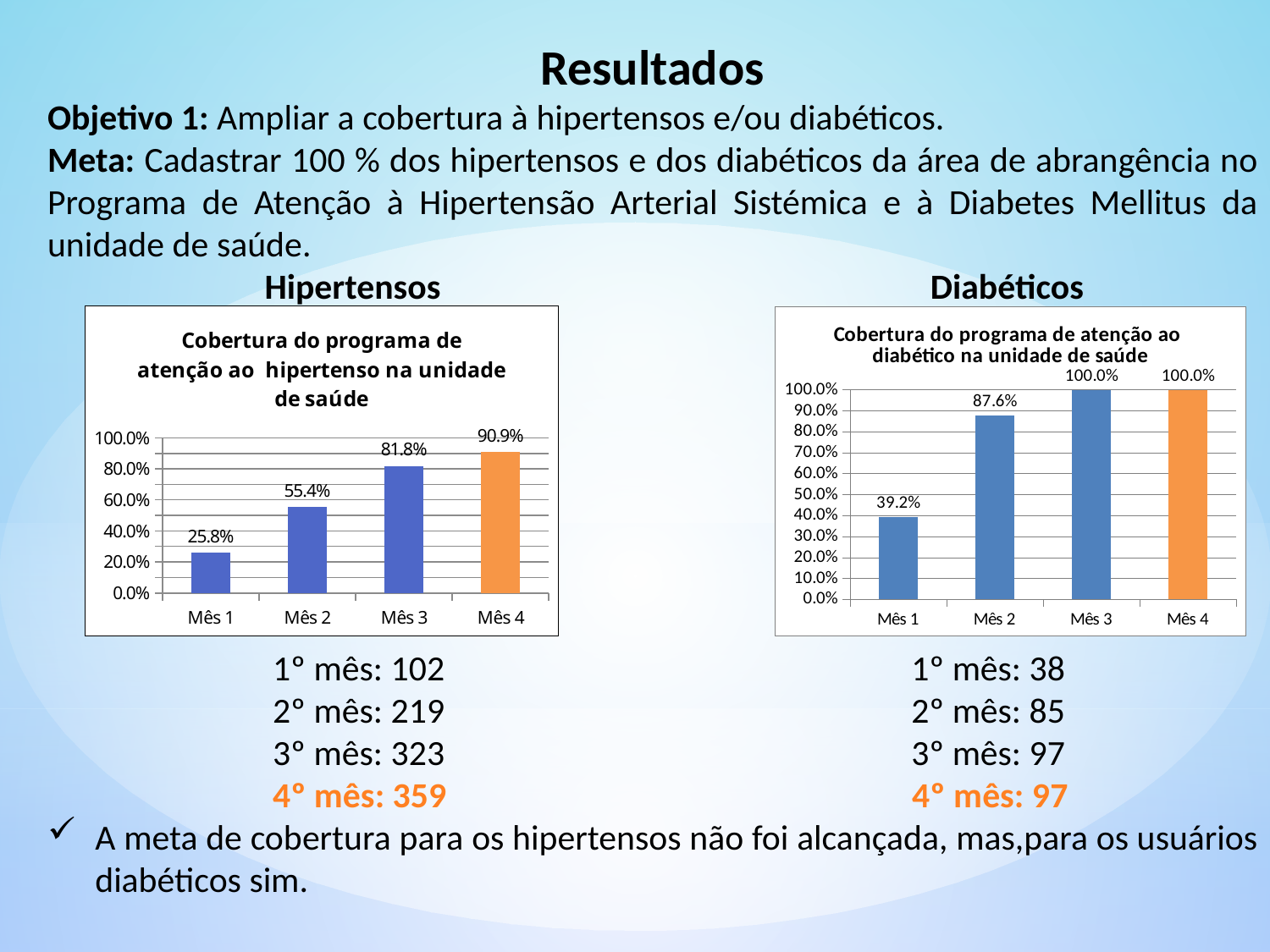
In the Hipertensos chart, which month has the highest value? Mês 4 In the Hipertensos chart, what is the value for Mês 2? 55.4% In the Diabéticos chart, what is the value for Mês 1? 39.2% In the Diabéticos chart, what is the difference between the values for Mês 2 and Mês 1? 48.4% In the Hipertensos chart, which month has the lowest value? Mês 1 In the Diabéticos chart, which month has the lowest value? Mês 1 In the Hipertensos chart, what is the difference between the values for Mês 3 and Mês 1? 56.0% What kind of chart is the Hipertensos chart? Bar chart Which is larger: the Mês 2 value in the Hipertensos chart or the Mês 2 value in the Diabéticos chart? Diabéticos chart In the Hipertensos chart, what is the value for Mês 4? 90.9% How many months are plotted in the Diabéticos chart? 4 In the Diabéticos chart, what is the value for Mês 2? 87.6%